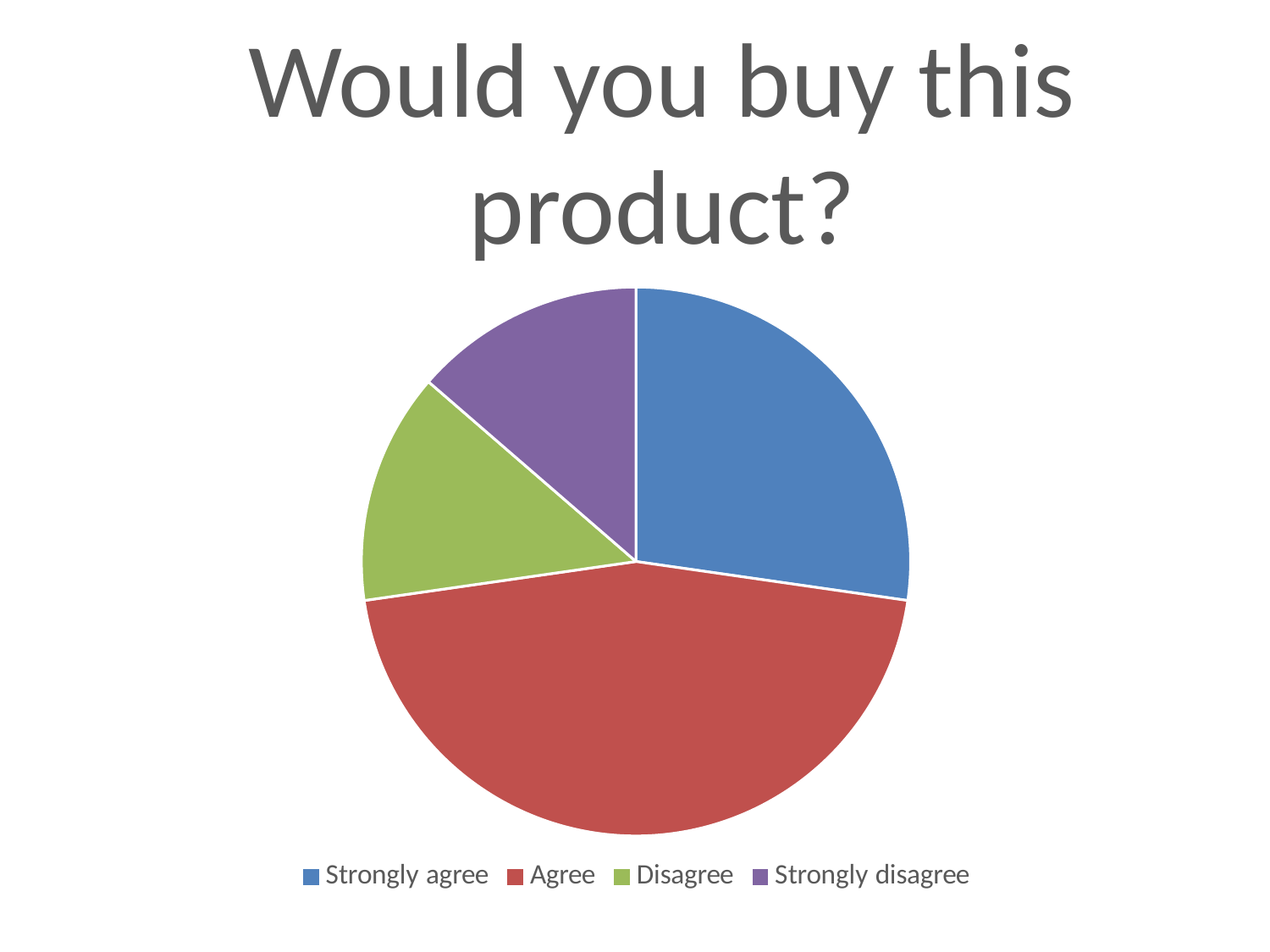
What kind of chart is shown on the slide? Pie chart Which slice is larger, Strongly agree or Disagree? Strongly agree How many categories does the pie chart have? 4 Which category is shown in red? Agree What is the title of the chart? Would you buy this product? Which slice is larger, Agree or Strongly disagree? Agree Which slice is larger, Agree or Strongly agree? Agree Which category has the largest slice of the pie? Agree